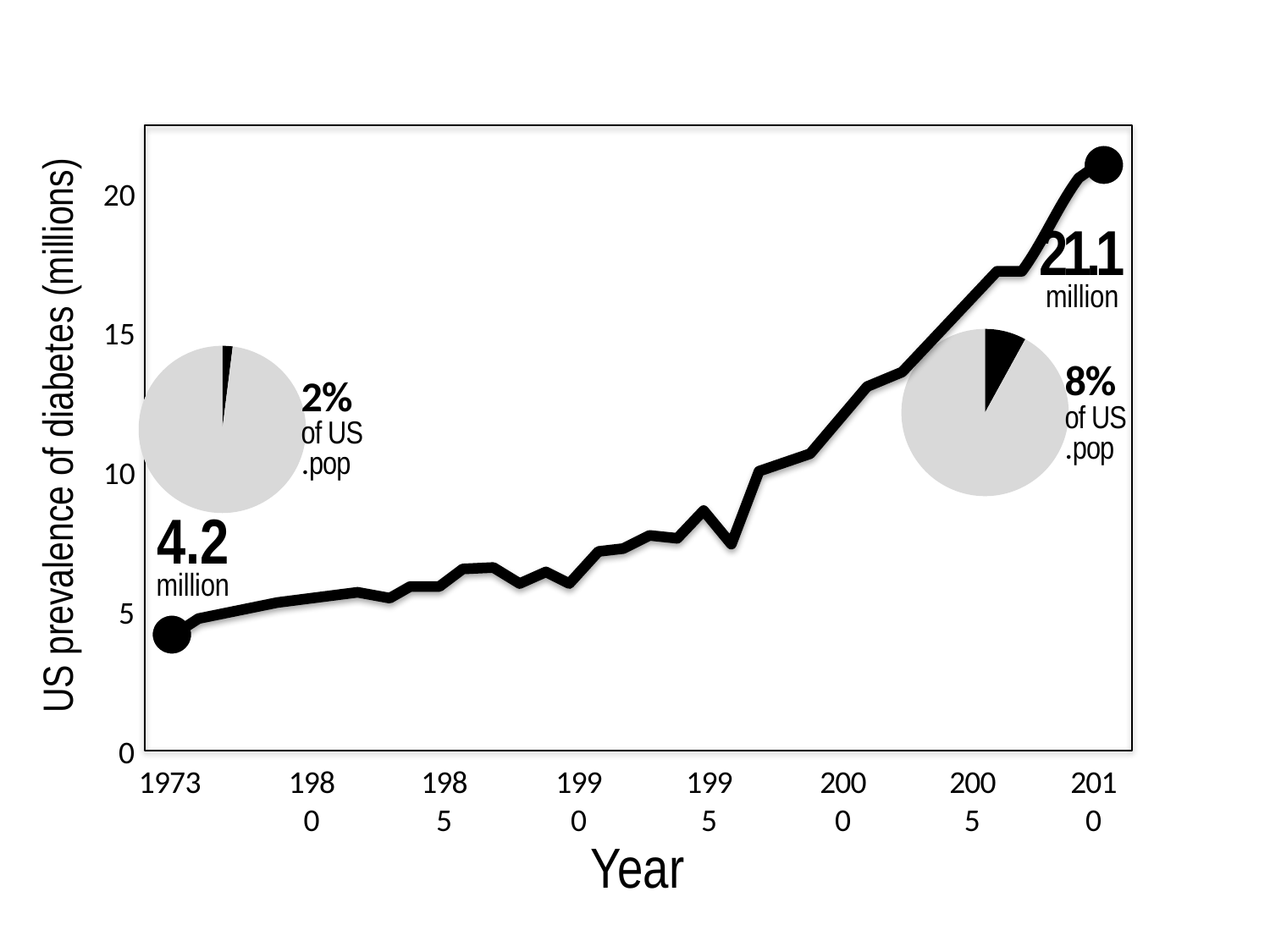
In which year does the line reach its highest value? 2010 Is the value for 1990 greater or less than 10 million? less What kind of chart is the main chart on the slide? line chart What is the US prevalence of diabetes shown for 2010? 21.1 million According to the small pie chart next to the 2010 point, what share of the US population had diabetes? 8% Is the value for 2005 greater or less than 10 million? greater Which year has the higher prevalence of diabetes, 1973 or 2010? 2010 Does the US prevalence of diabetes generally rise or fall from 1973 to 2010? rise According to the small pie chart next to the 1973 point, what share of the US population had diabetes? 2% By how many million did the US prevalence of diabetes increase from 1973 to 2010, based on the labelled values? 16.9 million What is the label of the vertical axis? US prevalence of diabetes (millions) What is the US prevalence of diabetes shown for 1973? 4.2 million